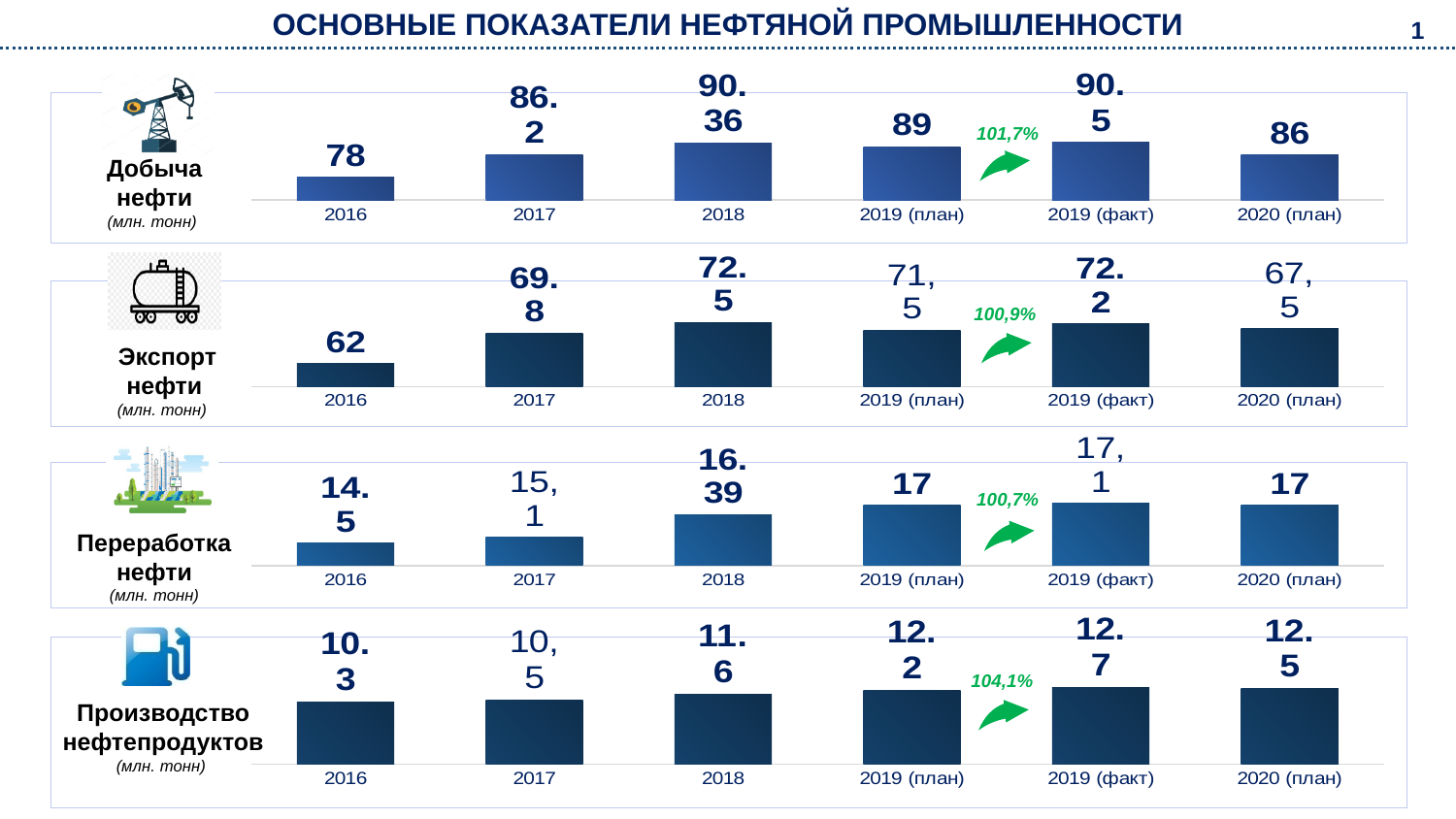
In the Производство нефтепродуктов chart, what is the difference between the 2019 (факт) value and the 2019 (план) value? 0.5 In the Переработка нефти chart, what is the value for 2018? 16.39 In the Добыча нефти chart, what is the value for 2016? 78 What kind of chart is the Экспорт нефти chart? bar chart In the Добыча нефти chart, which category has the highest value? 2019 (факт) In the Экспорт нефти chart, which category has the lowest value? 2016 In the Экспорт нефти chart, what is the value for 2018? 72.5 In the Производство нефтепродуктов chart, what is the value for 2019 (факт)? 12.7 In the Производство нефтепродуктов chart, do the values rise or fall from 2016 to 2019 (факт)? rise How many categories are shown in the Добыча нефти chart? 6 In the Экспорт нефти chart, what is the difference between the 2017 value and the 2016 value? 7.8 In the Переработка нефти chart, which is larger, the value for 2016 or the value for 2017? 2017